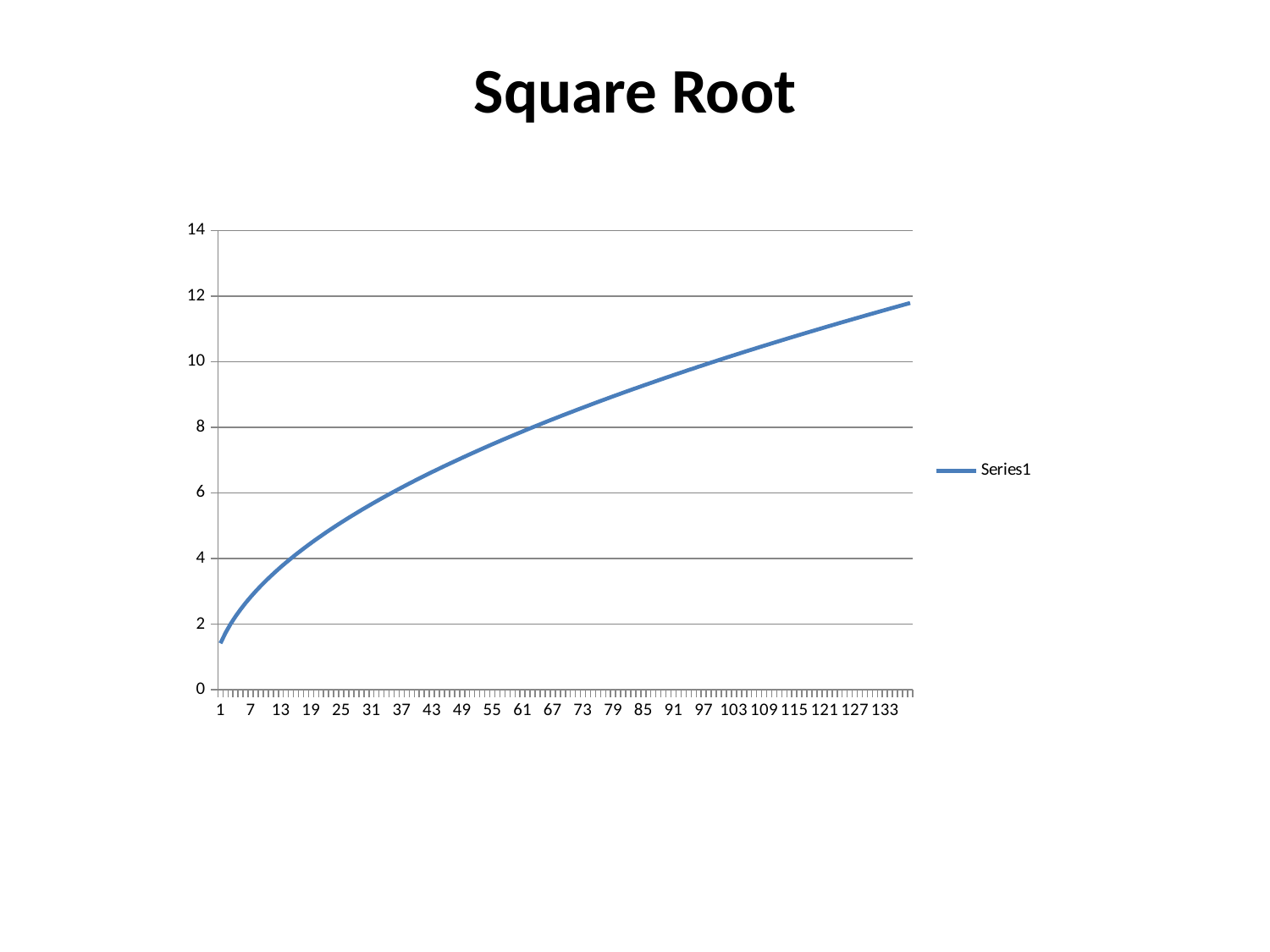
Is the value at x = 133 greater or less than 10? greater Is the value at x = 25 greater or less than 6? less What is the name of the series shown in the legend? Series1 What is the title of the chart? Square Root Is the value at x = 49 greater or less than 6? greater How many series does the legend list? 1 Is the value at x = 133 larger or smaller than the value at x = 1? larger At which x value is the plotted value lowest? 1 Do the values rise or fall as you move from left to right along the x axis? rise What kind of chart is shown on the slide? line chart